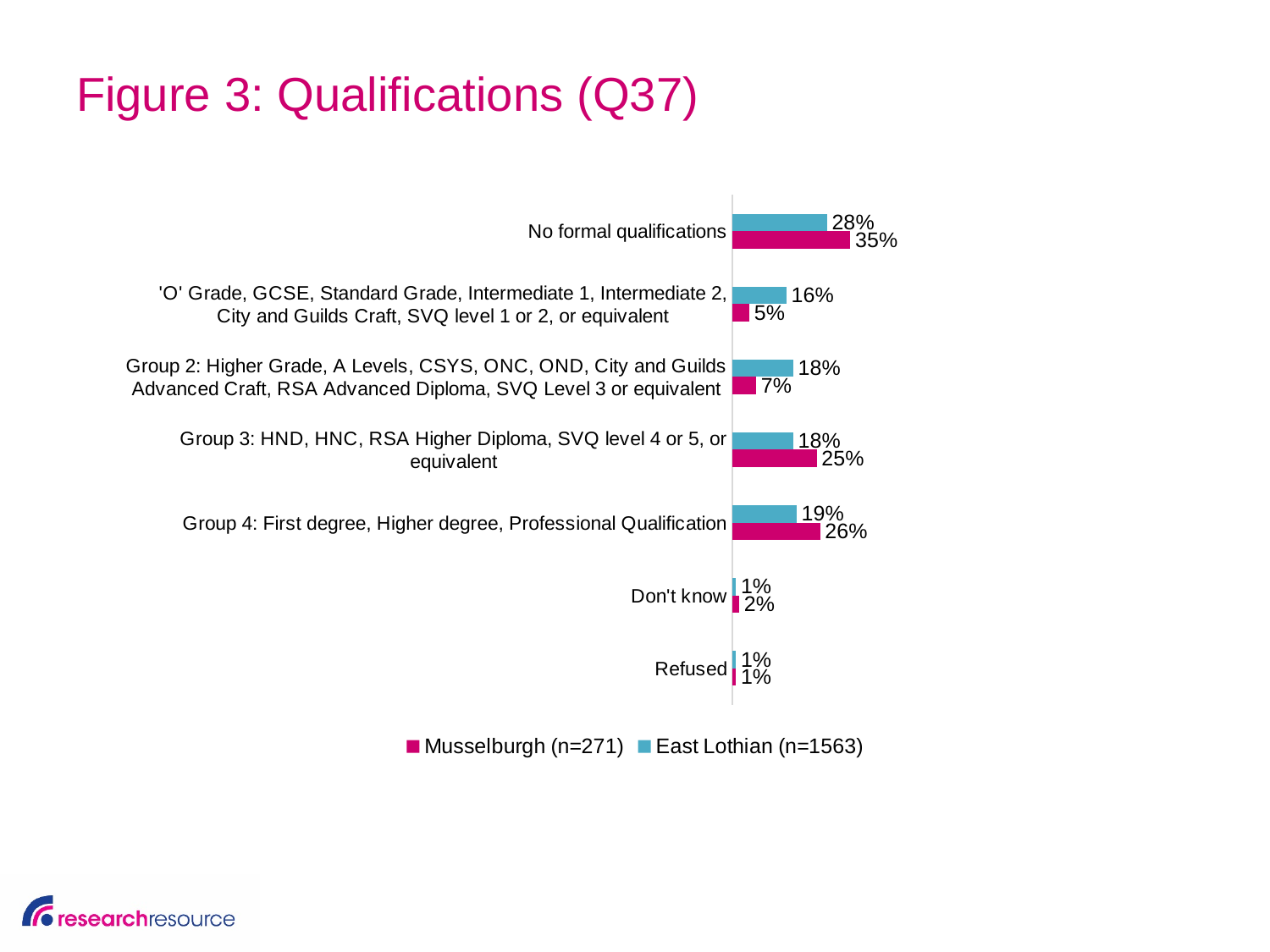
For Group 3: HND, HNC, RSA Higher Diploma, SVQ level 4 or 5, or equivalent, which area has the larger value, Musselburgh or East Lothian? Musselburgh Which category has the highest Musselburgh value? No formal qualifications What is the Musselburgh value for Group 4: First degree, Higher degree, Professional Qualification? 26% What is the difference between the Musselburgh and East Lothian values for No formal qualifications? 7 percentage points How many series does the legend list? 2 For the 'O' Grade, GCSE, Standard Grade category, which area has the larger value? East Lothian How many categories are shown on the chart? 7 Which category has the lowest East Lothian value? Don't know and Refused (both 1%) What percentage of Musselburgh respondents have no formal qualifications? 35% What percentage of East Lothian respondents have no formal qualifications? 28% What type of chart is shown on the slide? Bar chart What is the East Lothian value for Group 2: Higher Grade, A Levels, CSYS, ONC, OND, City and Guilds Advanced Craft, RSA Advanced Diploma, SVQ Level 3 or equivalent? 18%